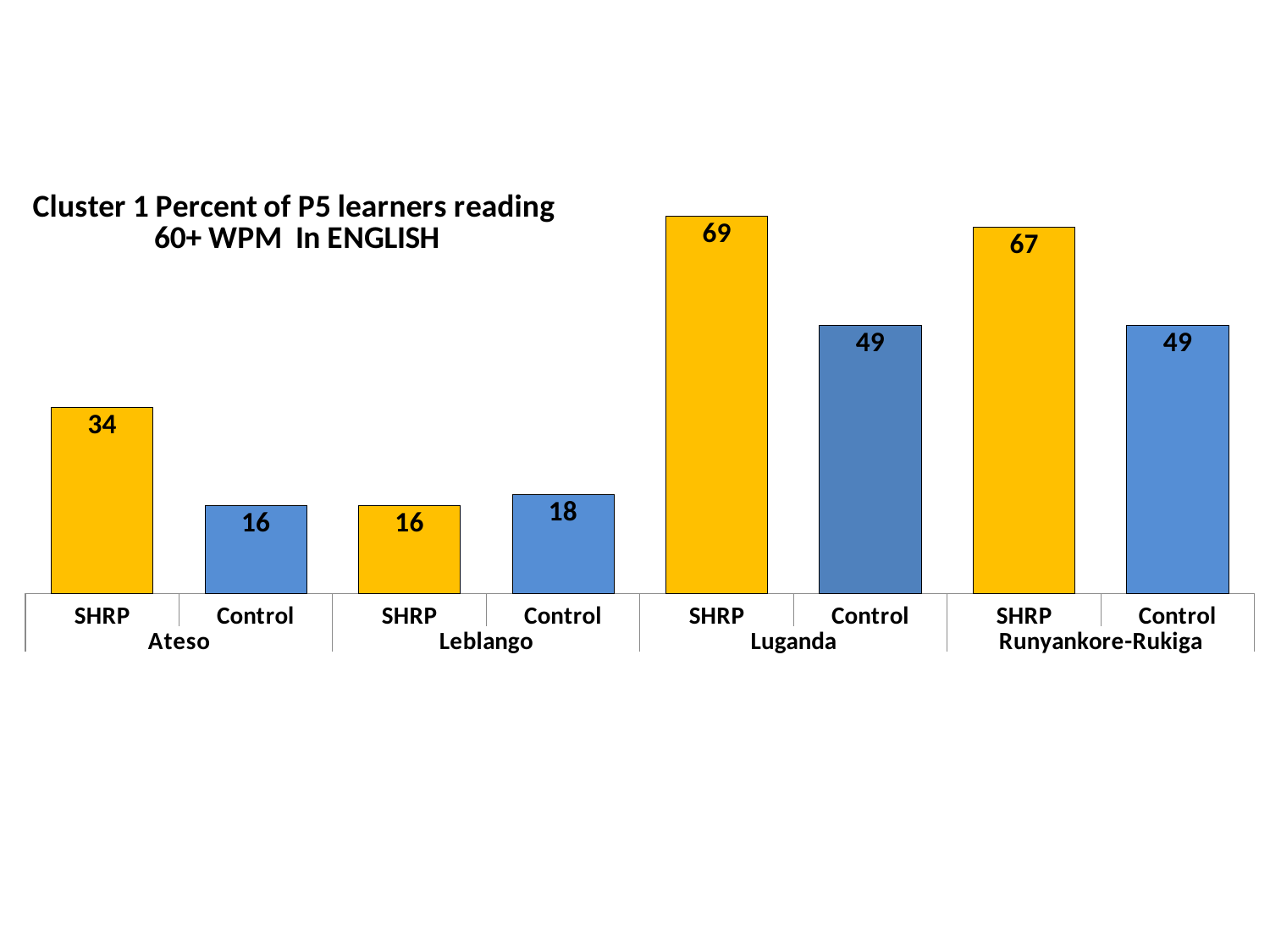
Which bar has the highest value? SHRP in Luganda Which is larger in Leblango, SHRP or Control? Control How many language groups are shown on the x axis? 4 What is the value for SHRP in Runyankore-Rukiga? 67 What is the value for Control in Luganda? 49 What is the value for SHRP in Ateso? 34 What is the title of the chart? Cluster 1 Percent of P5 learners reading 60+ WPM In ENGLISH Which is larger, SHRP in Luganda or SHRP in Runyankore-Rukiga? SHRP in Luganda What kind of chart is this? Bar chart What is the difference between SHRP and Control in Luganda? 20 What is the value for Control in Leblango? 18 What is the difference between SHRP and Control in Ateso? 18